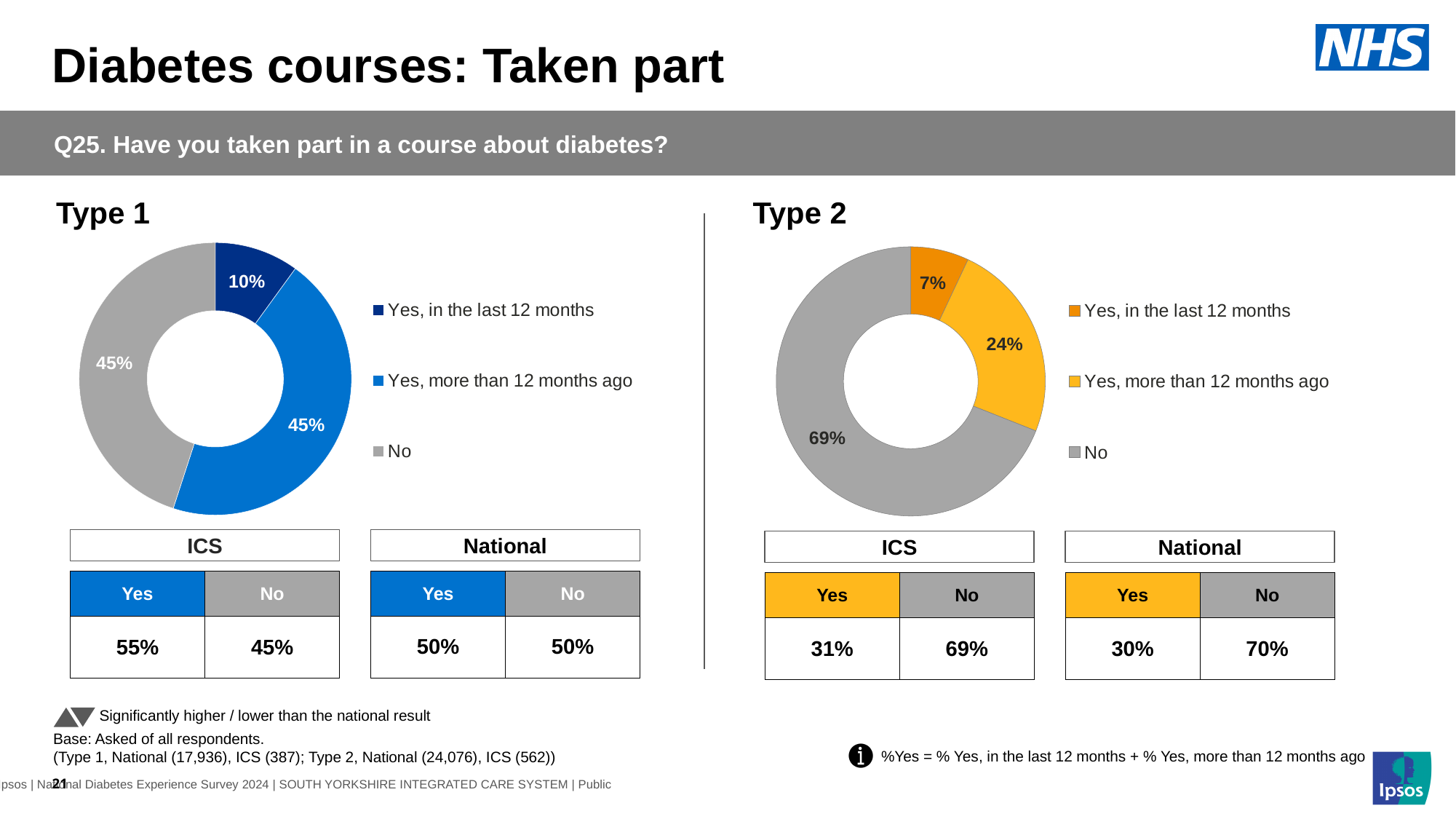
In the Type 2 chart, what is the difference between the 'No' share and the 'Yes, more than 12 months ago' share? 45 percentage points What kind of chart is used for Type 1? Doughnut chart How many entries does the legend of the Type 1 chart list? 3 In the Type 1 chart, what colour is the 'No' segment? Grey In the Type 1 chart, which category has the smallest share? Yes, in the last 12 months In the Type 2 chart, which category has the largest share? No Which is larger in the Type 1 chart: 'Yes, in the last 12 months' or 'Yes, more than 12 months ago'? Yes, more than 12 months ago In the Type 2 chart, what is the combined share of the two 'Yes' categories? 31% In the Type 1 chart, what percentage answered 'Yes, in the last 12 months'? 10% How many categories does the Type 2 chart show? 3 In the Type 2 chart, what percentage answered 'No'? 69% In the Type 2 chart, what percentage answered 'Yes, more than 12 months ago'? 24%